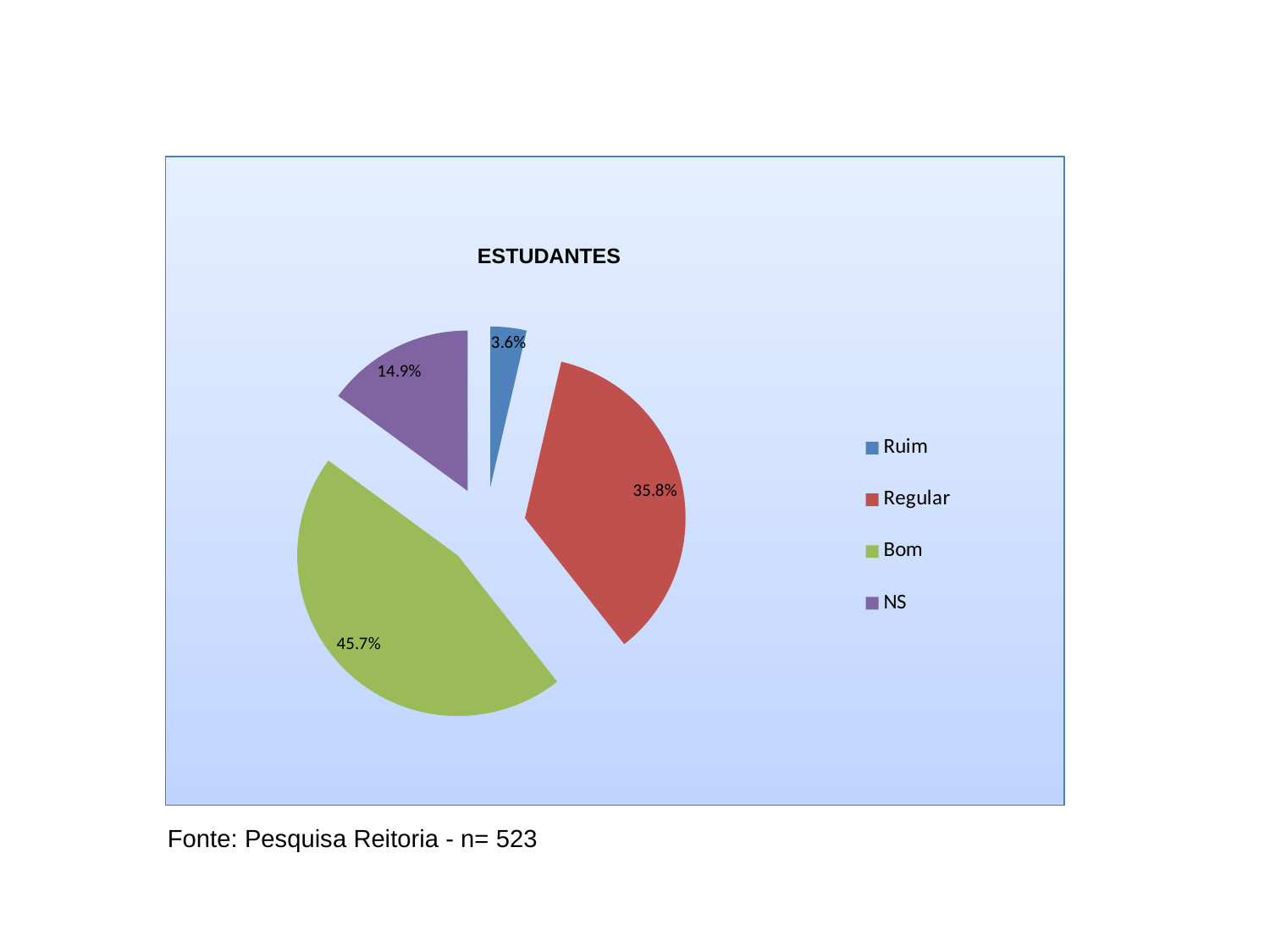
Which slice is larger, Regular or NS? Regular How many categories does the legend list? 4 What is the difference in percentage points between the Bom and Regular slices? 9.9 Which category has the largest slice of the pie? Bom Which category has the smallest slice of the pie? Ruim What percentage of the pie is labelled for Bom? 45.7% What percentage of the pie is labelled for NS? 14.9% What percentage of the pie is labelled for Ruim? 3.6% What type of chart is shown on the slide? pie chart What percentage of the pie is labelled for Regular? 35.8% What is the title of the pie chart? ESTUDANTES What colour is the slice for Bom? green